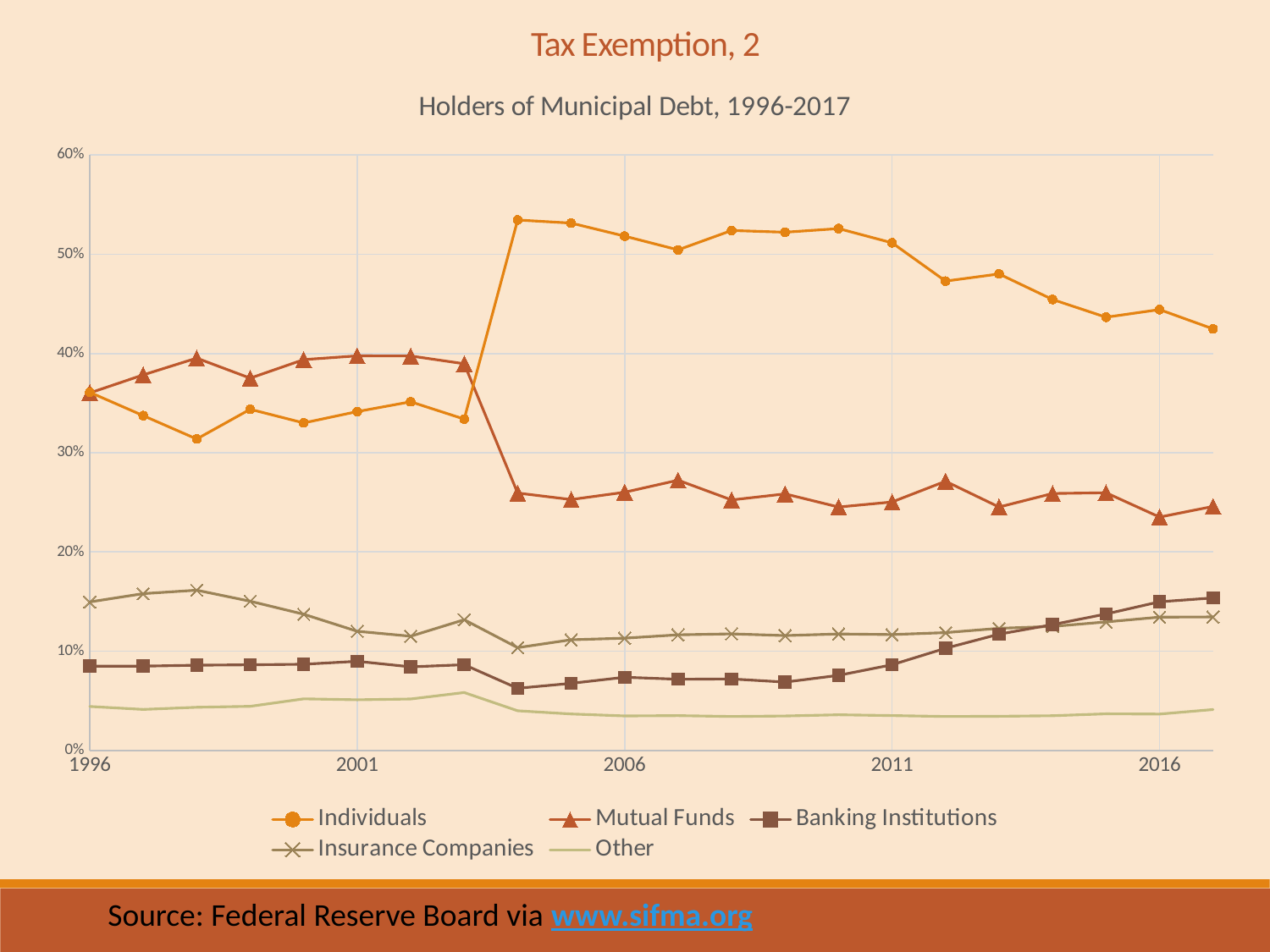
Which series has the highest value in 2016? Individuals What is the title of the chart? Holders of Municipal Debt, 1996-2017 Is the value for Mutual Funds in 2006 greater or less than 30%? less Which series is drawn with triangle markers? Mutual Funds What kind of chart is shown on the slide? line chart Is the value for Banking Institutions in 1996 greater or less than 10%? less Do the values for Individuals rise or fall from 2011 to 2016? fall How many series does the legend list? 5 Is the value for Individuals in 2016 greater or less than 40%? greater Which is larger in 2011, the value for Individuals or the value for Mutual Funds? Individuals Which series has the lowest value in 2006? Other